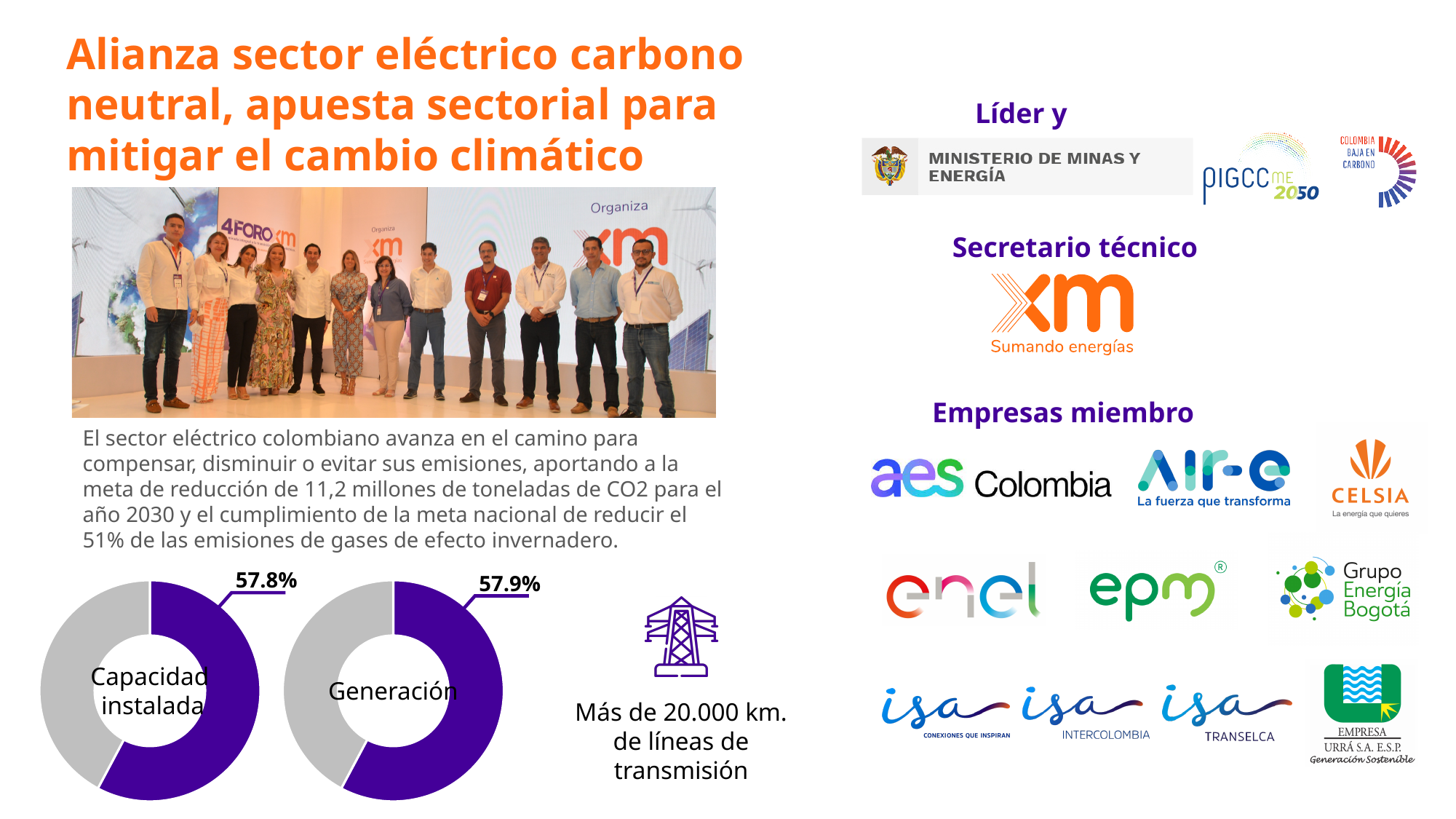
What is the difference between the labelled percentage in the 'Generación' chart and the labelled percentage in the 'Capacidad instalada' chart? 0.1% In the 'Generación' chart, which slice is larger, the purple one or the grey one? The purple one What colour is the slice labelled 57.8% in the 'Capacidad instalada' chart? Purple How many slices does the 'Capacidad instalada' donut chart have? 2 What kind of chart is the 'Capacidad instalada' chart? Donut (pie) chart Which chart shows the higher labelled percentage, 'Capacidad instalada' or 'Generación'? Generación In the 'Capacidad instalada' chart, what percentage is shown for the purple slice? 57.8% How many slices does the 'Generación' donut chart have? 2 How many donut charts are shown on the slide? 2 In the 'Capacidad instalada' chart, which slice is larger, the purple one or the grey one? The purple one What kind of chart is the 'Generación' chart? Donut (pie) chart In the 'Generación' chart, what percentage is shown for the purple slice? 57.9%